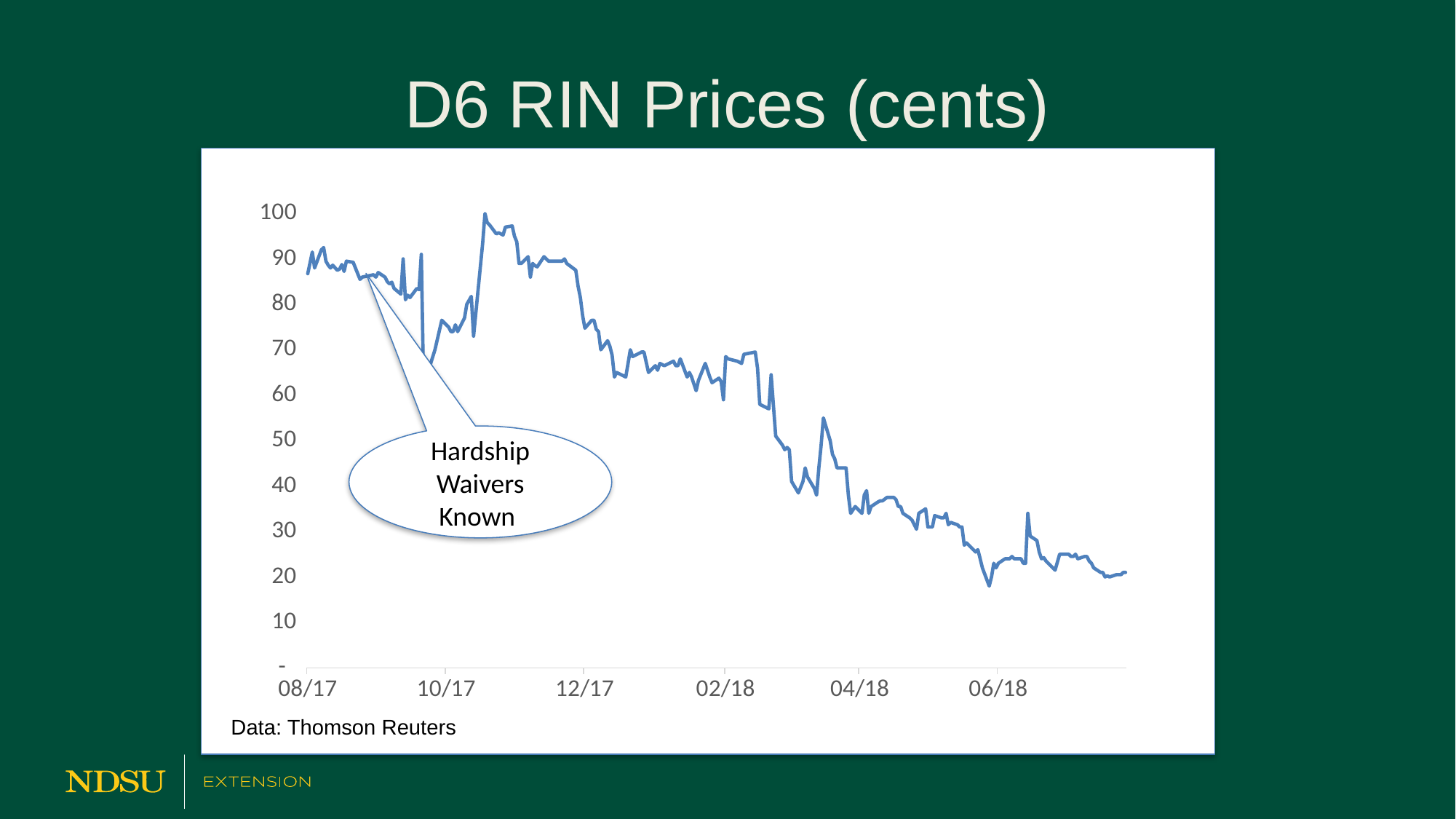
How many date labels are shown on the x axis? 6 Is the D6 RIN price at 08/17 greater or less than 80? greater How many lines (series) are plotted on the chart? 1 What is the title of the chart? D6 RIN Prices (cents) Is the highest D6 RIN price reached on the chart greater or less than 90? greater What event does the callout on the chart point to? Hardship Waivers Known What kind of chart is shown on the slide? line chart Is the D6 RIN price at 12/17 greater or less than 80? greater Overall, do D6 RIN prices rise or fall from 08/17 to the end of the series? fall Which is higher, the D6 RIN price at 08/17 or at 06/18? 08/17